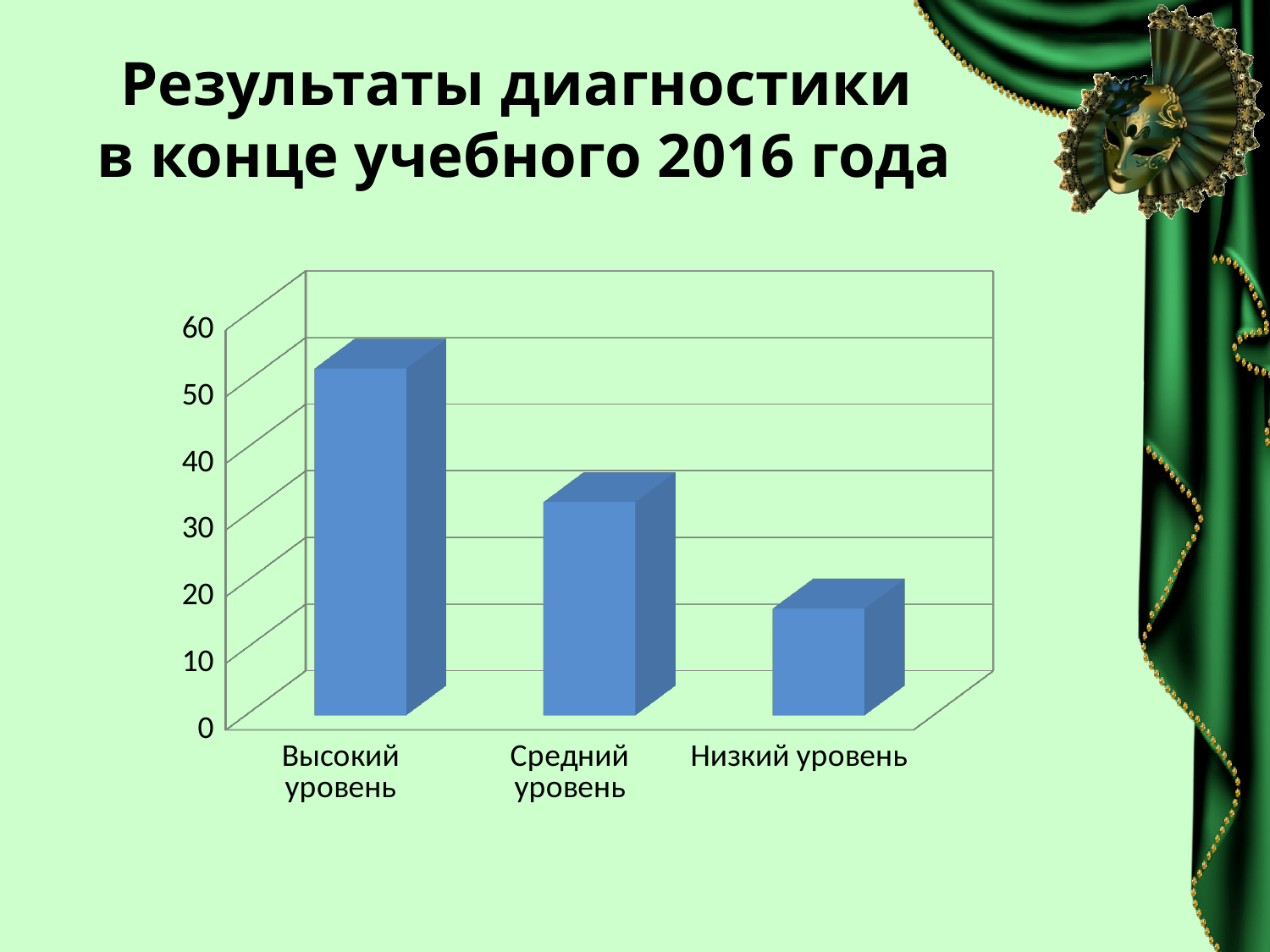
What is the title of the slide containing the chart? Результаты диагностики в конце учебного 2016 года Do the bar values rise or fall from left to right along the x axis? fall Which is larger, the value for Средний уровень or the value for Низкий уровень? Средний уровень Is the value for Низкий уровень greater or less than 10? greater Is the value for Высокий уровень greater or less than 40? greater Is the value for Средний уровень greater or less than 40? less Which category has the highest bar? Высокий уровень What kind of chart is shown on the slide? bar chart How many categories are shown on the x axis of the chart? 3 Which category has the lowest bar? Низкий уровень Which is larger, the value for Высокий уровень or the value for Средний уровень? Высокий уровень